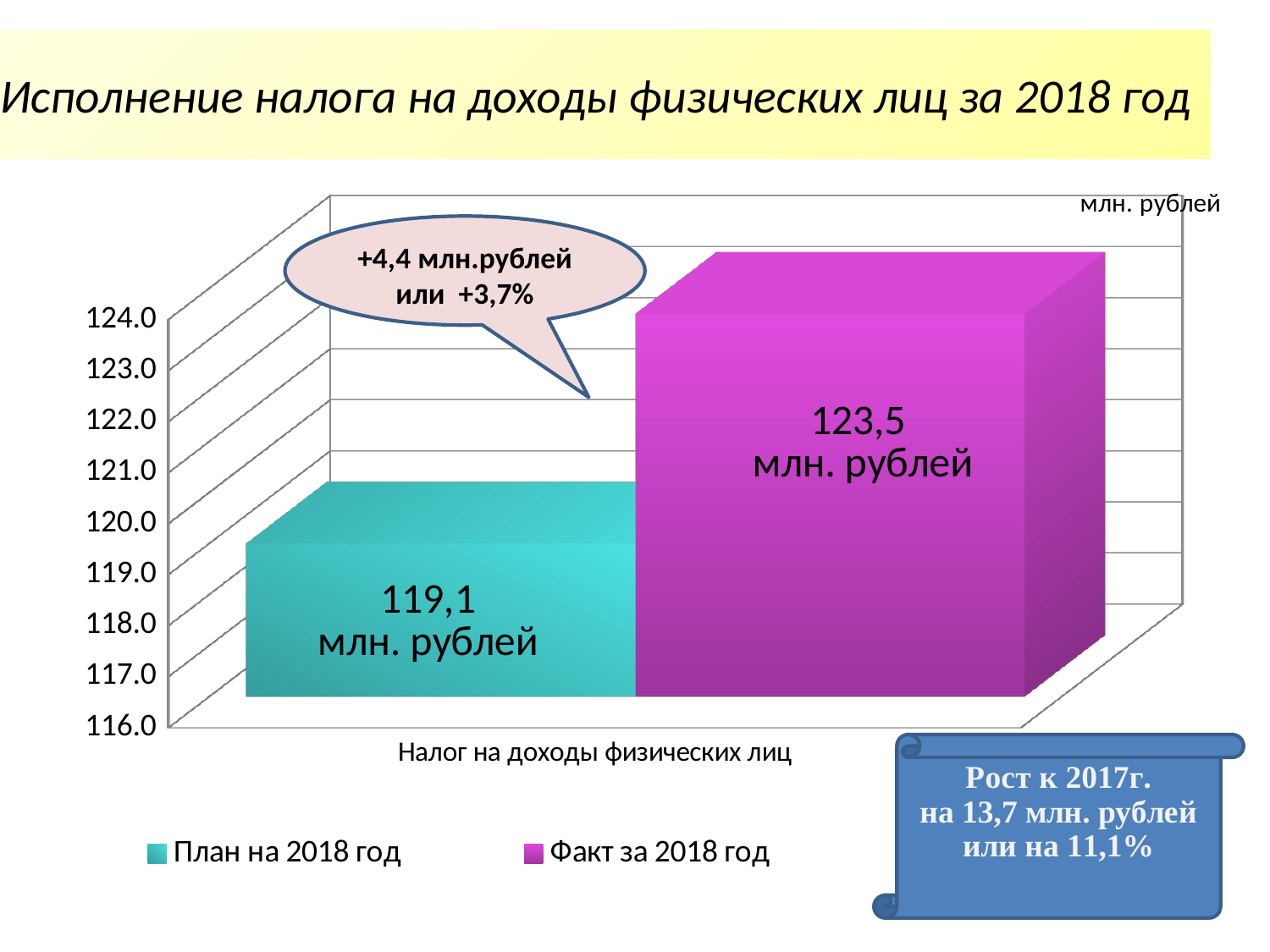
Is the value for "План на 2018 год" greater or less than 120.0? less Which series shows the lowest value on the chart? План на 2018 год What kind of chart is shown on the slide? Bar chart What is the category label shown on the x axis of the chart? Налог на доходы физических лиц Is the value for "Факт за 2018 год" greater or less than 122.0? greater What is the value for the series "Факт за 2018 год"? 123,5 млн. рублей Which series shows the highest value on the chart? Факт за 2018 год How many series does the legend list? 2 What is the difference between the "Факт за 2018 год" value and the "План на 2018 год" value? 4,4 млн. рублей What is the value for the series "План на 2018 год"? 119,1 млн. рублей What unit is indicated in the top right corner of the chart? млн. рублей Which series has the higher value, "План на 2018 год" or "Факт за 2018 год"? Факт за 2018 год